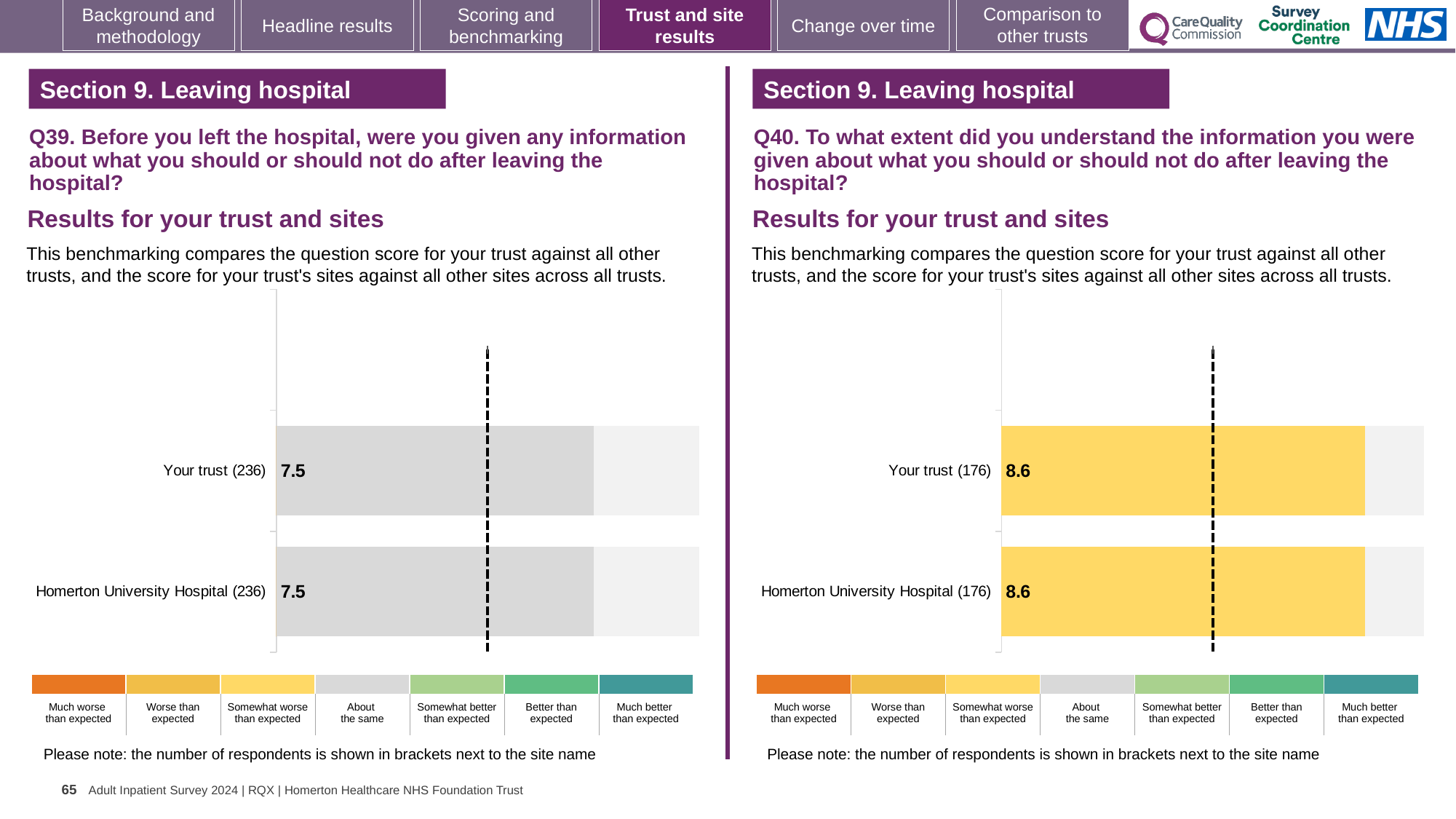
How many bars are plotted in the Q40 chart on the right? 2 In the Q40 chart on the right, what is the score for Your trust? 8.6 In the Q39 chart on the left, how many respondents are shown in brackets next to Your trust? 236 In the Q40 chart on the right, what is the difference between the score for Your trust and the score for Homerton University Hospital? 0 In the Q39 chart on the left, what is the score for Homerton University Hospital? 7.5 What type of chart is used for the Q39 results on the left? Bar chart In the Q40 chart on the right, what is the score for Homerton University Hospital? 8.6 In the Q39 chart on the left, what is the difference between the score for Your trust and the score for Homerton University Hospital? 0 How many bars are plotted in the Q39 chart on the left? 2 According to the colour key, which benchmarking category do the yellow bars in the Q40 chart on the right represent? Somewhat worse than expected In the Q39 chart on the left, what is the score for Your trust? 7.5 In the Q40 chart on the right, how many respondents are shown in brackets next to Homerton University Hospital? 176